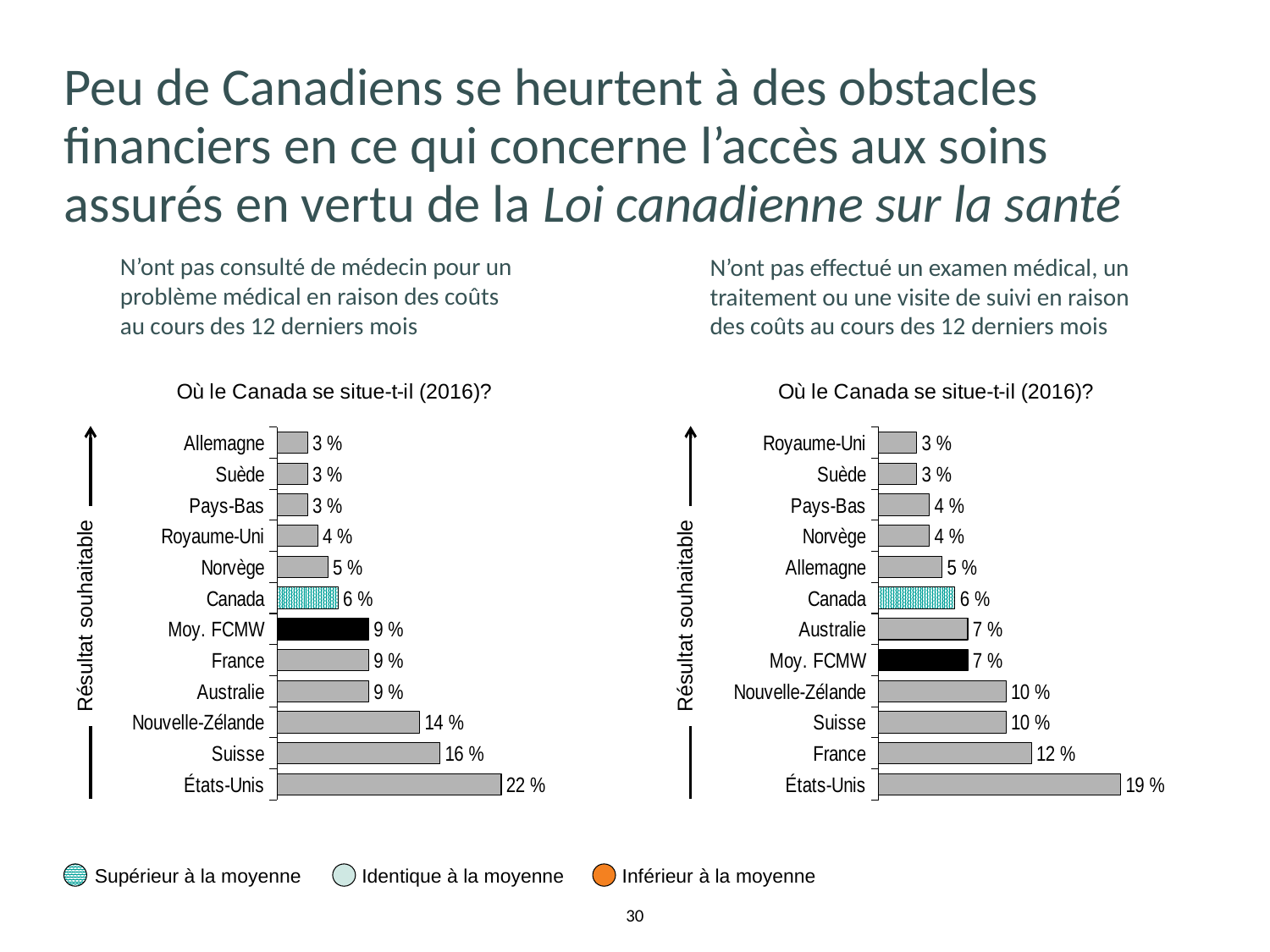
How many categories are plotted in the left chart? 12 In the right chart (not completing a medical exam, treatment or follow-up due to costs), what is the value for France? 12 % In the right chart, which category has the highest value? États-Unis In the right chart, what is the difference between the value for États-Unis and the value for Moy. FCMW? 12 % What is the title of the left chart? Où le Canada se situe-t-il (2016)? In the right chart, which is larger: the value for Allemagne or the value for Canada? Canada In the left chart, what is the difference between the value for États-Unis and the value for Canada? 16 % In the left chart, which is larger: the value for Suisse or the value for Nouvelle-Zélande? Suisse In the left chart (not consulting a doctor due to costs), what is the value for Canada? 6 % In the left chart, which category has the highest value? États-Unis In the left chart, what is the value for Moy. FCMW? 9 % What kind of chart is the right chart? Bar chart